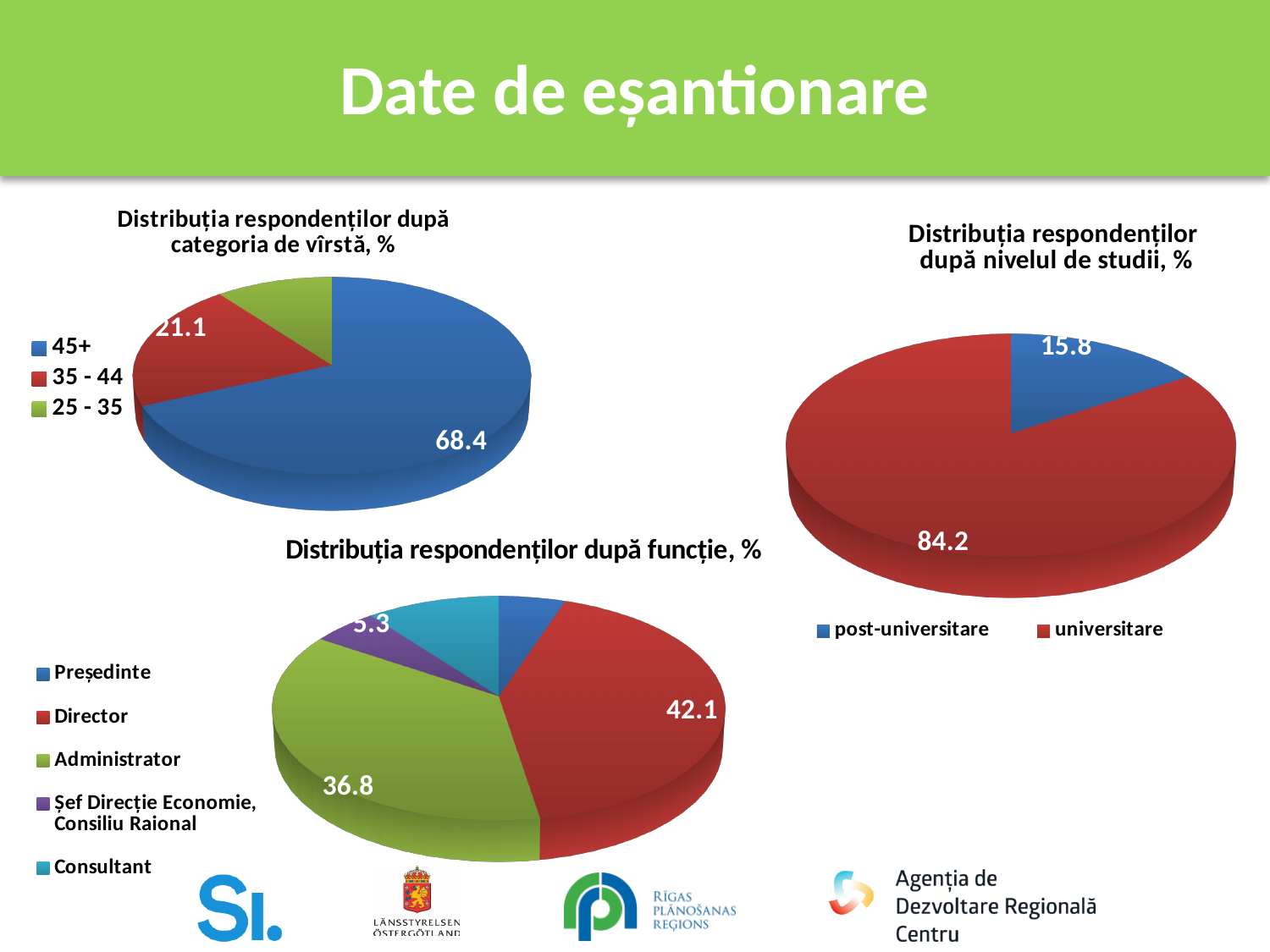
In the chart 'Distribuția respondenților după categoria de vîrstă, %', what is the value for 35 - 44? 21.1 In the chart 'Distribuția respondenților după funcție, %', what is the value for Director? 42.1 How many categories does the legend of 'Distribuția respondenților după categoria de vîrstă, %' list? 3 How many categories does the legend of 'Distribuția respondenților după funcție, %' list? 5 In the chart 'Distribuția respondenților după nivelul de studii, %', which category has the largest share? universitare What kind of chart is 'Distribuția respondenților după categoria de vîrstă, %'? pie chart In the chart 'Distribuția respondenților după funcție, %', which is larger, Director or Administrator? Director In the chart 'Distribuția respondenților după nivelul de studii, %', what is the value for universitare? 84.2 In the chart 'Distribuția respondenților după funcție, %', what is the value for Administrator? 36.8 In the chart 'Distribuția respondenților după categoria de vîrstă, %', what is the difference between the values for 45+ and 35 - 44? 47.3 In the chart 'Distribuția respondenților după nivelul de studii, %', what is the value for post-universitare? 15.8 In the chart 'Distribuția respondenților după categoria de vîrstă, %', what is the value for 45+? 68.4